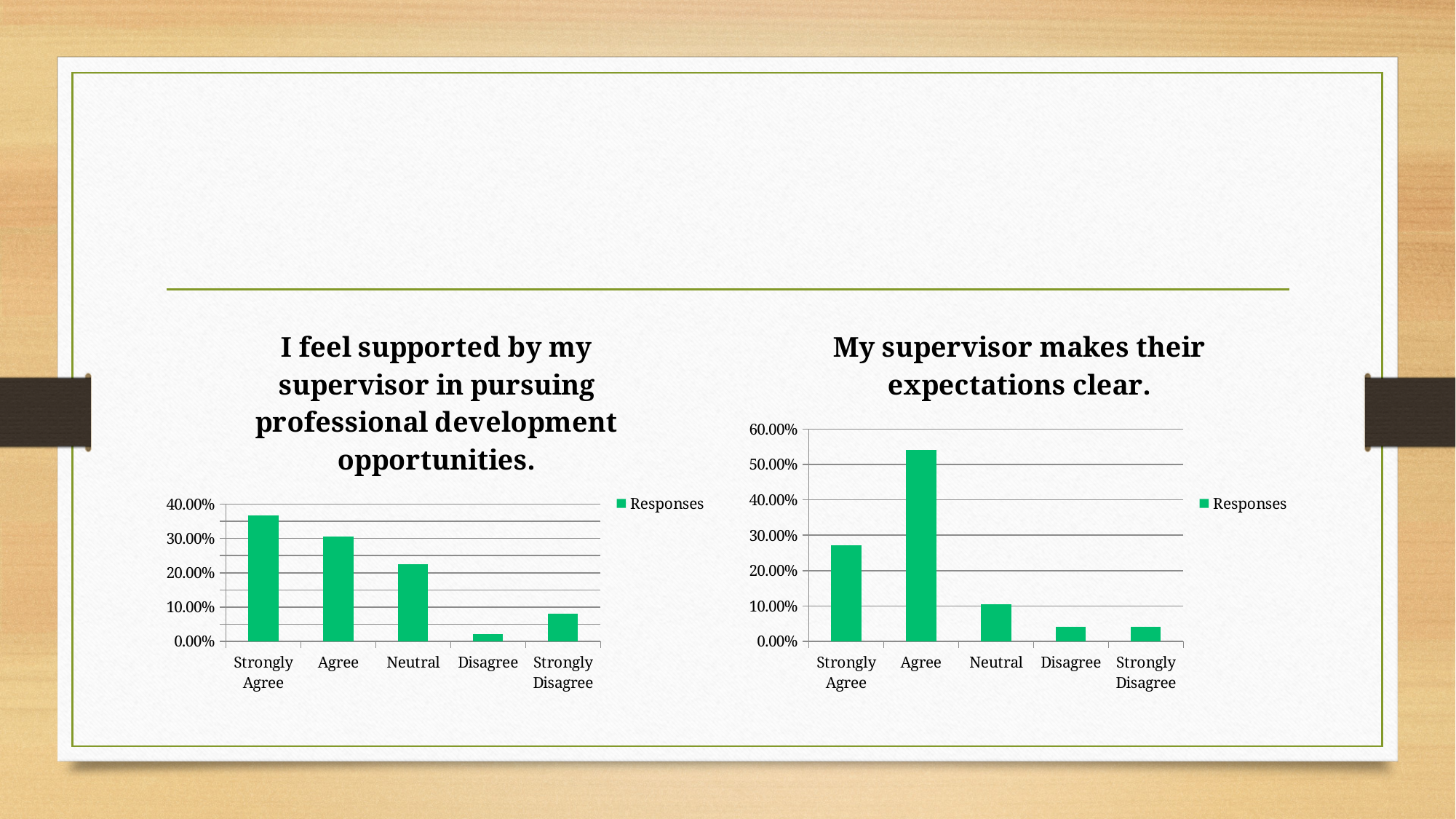
In the left chart, is the value for Strongly Agree greater or less than 30.00%? greater How many series does the legend of the left chart list? 1 In the chart titled "I feel supported by my supervisor in pursuing professional development opportunities.", which category has the lowest value? Disagree In the left chart, which is larger, the value for Agree or the value for Neutral? Agree In the right chart, which is larger, the value for Strongly Agree or the value for Neutral? Strongly Agree In the chart titled "My supervisor makes their expectations clear.", which category has the highest value? Agree What kind of chart is the chart titled "My supervisor makes their expectations clear."? Bar chart In the right chart, is the value for Agree greater or less than 50.00%? greater In the right chart, is the value for Strongly Agree greater or less than 30.00%? less How many categories are shown on the x axis of the chart titled "My supervisor makes their expectations clear."? 5 In the chart titled "I feel supported by my supervisor in pursuing professional development opportunities.", which category has the highest value? Strongly Agree